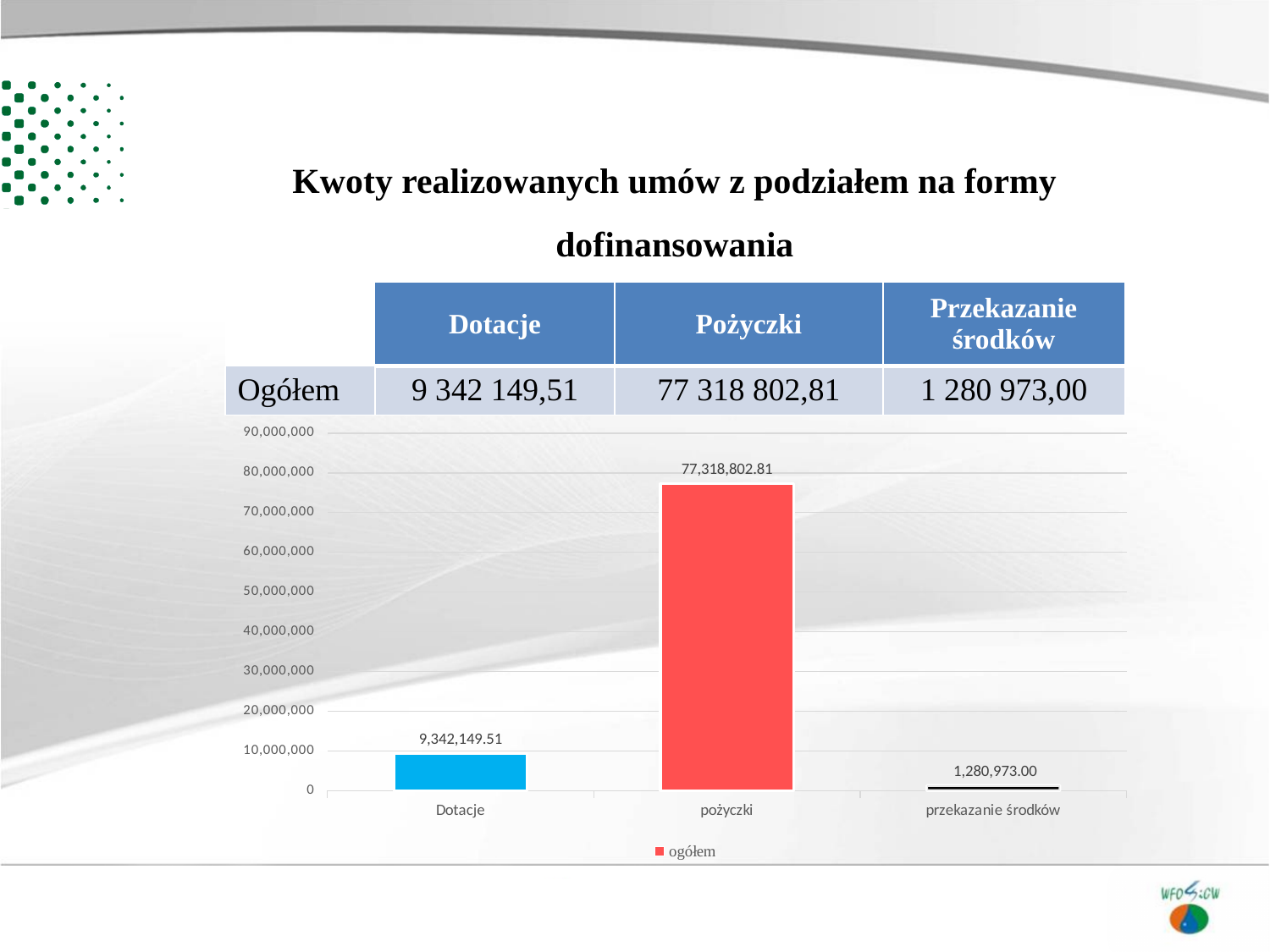
What kind of chart is shown on the slide? bar chart What is the difference between the values for pożyczki and Dotacje? 67,976,653.30 Which is larger, the value for Dotacje or the value for przekazanie środków? Dotacje How many categories are shown on the x axis of the chart? 3 Which category has the lowest bar? przekazanie środków What is the value of the bar for Dotacje? 9,342,149.51 What is the difference between the values for Dotacje and przekazanie środków? 8,061,176.51 What is the value of the bar for pożyczki? 77,318,802.81 Which category has the highest bar? pożyczki How many series does the chart legend list? 1 What is the value of the bar for przekazanie środków? 1,280,973.00 Is the value for pożyczki greater or less than 70,000,000? greater